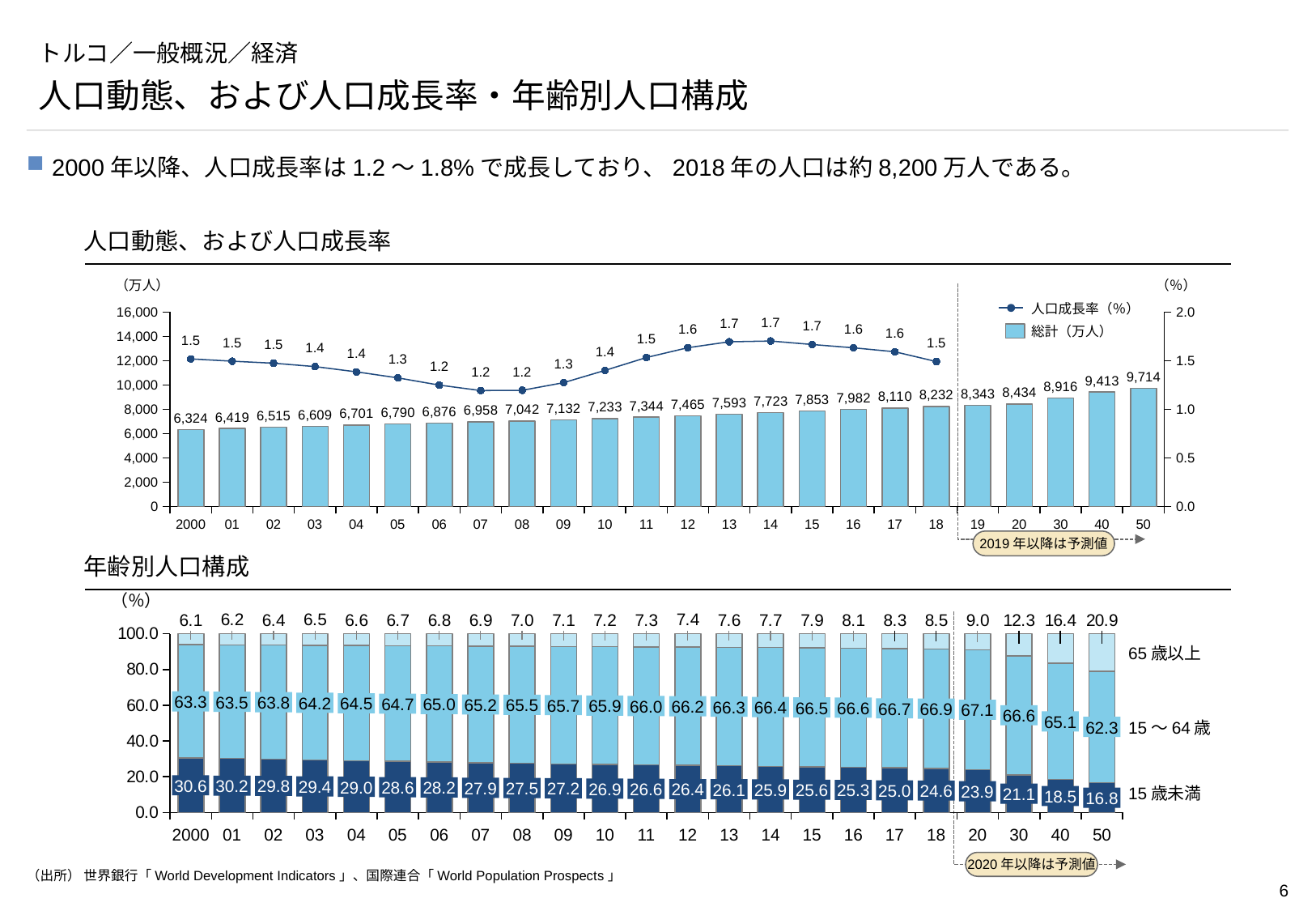
What kind of chart is the 年齢別人口構成 chart? Stacked bar chart In the 人口動態、および人口成長率 chart, what is the difference between the 総計 values for 50 and 2000? 3,390 How many bars are plotted in the 人口動態、および人口成長率 chart? 24 In the 年齢別人口構成 chart, does the 15歳未満 share rise or fall from 2000 to 50? Fall In the 人口動態、および人口成長率 chart, which year has the lowest 総計 (万人) value? 2000 In the 年齢別人口構成 chart, what is the 15歳未満 value for 50? 16.8 In the 年齢別人口構成 chart, what is the 65歳以上 value for 40? 16.4 In the 人口動態、および人口成長率 chart, what is the 人口成長率 (%) value for 2013? 1.7 In the 年齢別人口構成 chart, which is larger for 50: the 65歳以上 value or the 15歳未満 value? 65歳以上 In the 人口動態、および人口成長率 chart, which year has the highest 総計 (万人) value? 50 In the 人口動態、および人口成長率 chart, what is the 総計 (万人) value for 2018? 8,232 How many series does the legend of the 人口動態、および人口成長率 chart list? 2